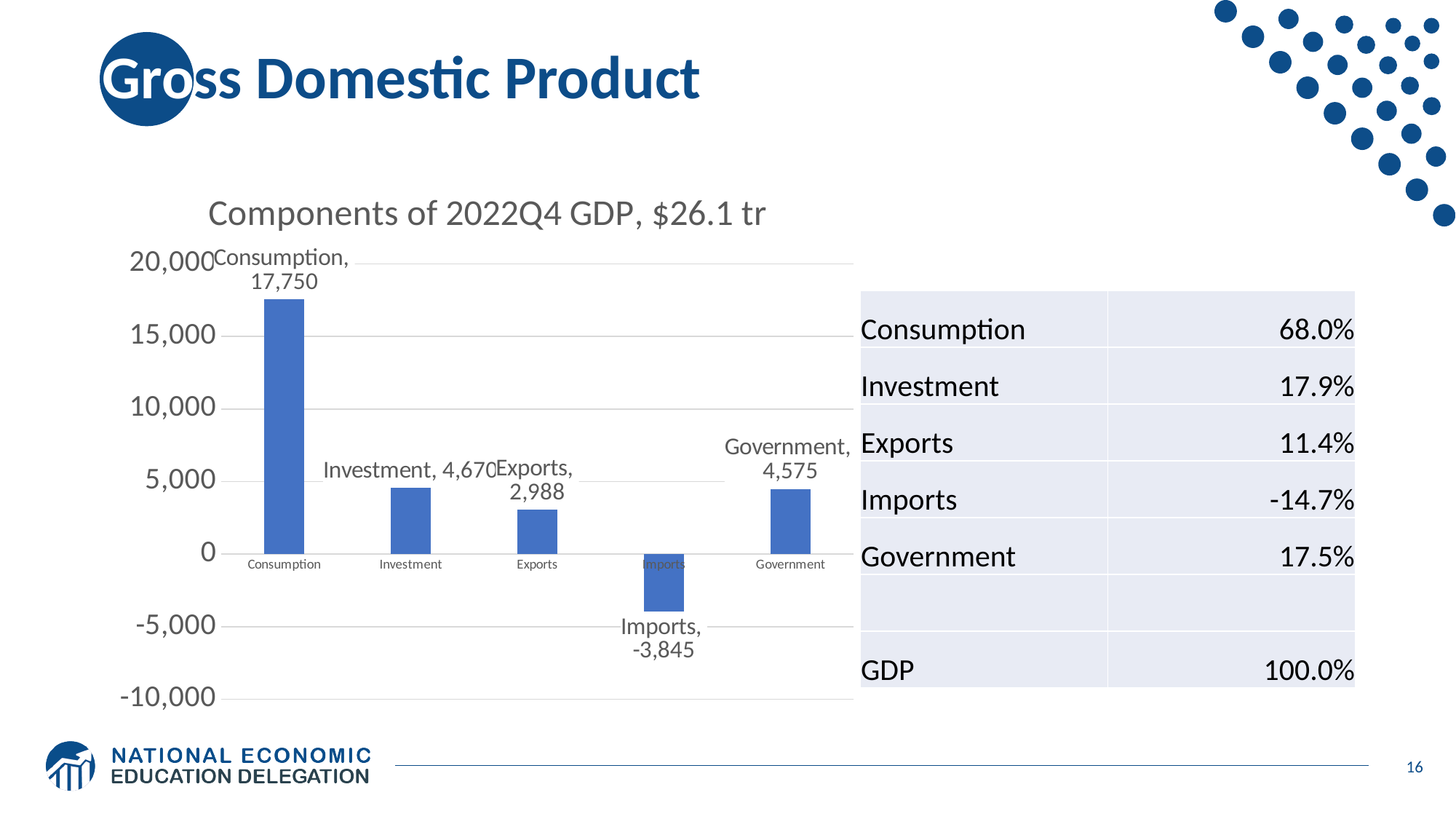
What kind of chart is shown on the slide? bar chart What is the title of the chart? Components of 2022Q4 GDP, $26.1 tr Which category has the highest value? Consumption How many categories are shown on the x axis? 5 What is the value for Consumption? 17,750 Which is larger, the value for Investment or the value for Exports? Investment What is the value for Government? 4,575 What is the difference between the values for Investment and Government? 95 What is the value for Exports? 2,988 Which category has the lowest value? Imports Is the value for Consumption greater or less than 15,000? greater What is the value for Imports? -3,845